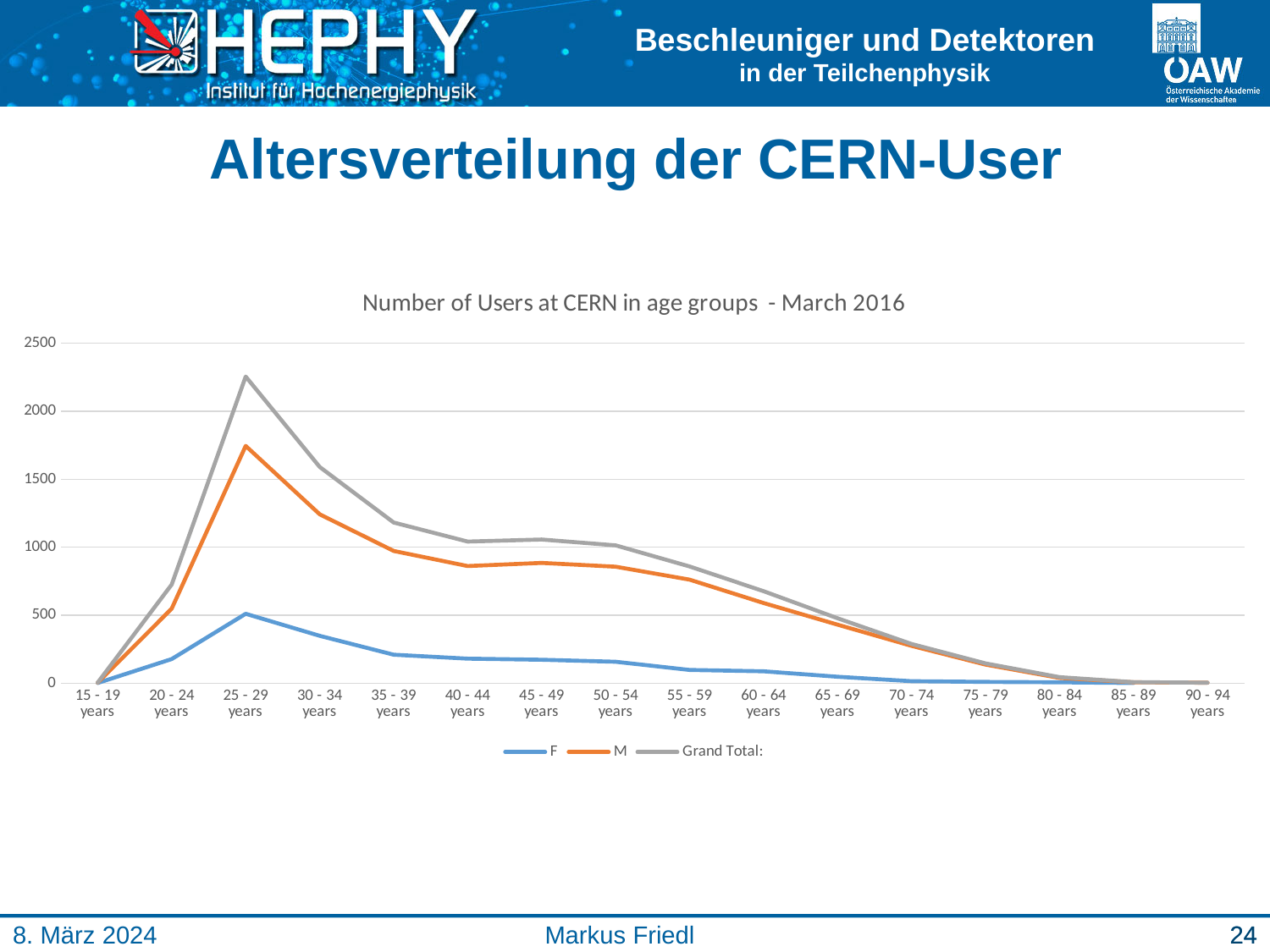
How many series does the legend list? 3 Which age group has the highest value for the M series? 25 - 29 years Is the Grand Total value for 25 - 29 years greater or less than 2000? greater How many age groups are shown on the x axis? 16 What is the title of the chart? Number of Users at CERN in age groups - March 2016 Is the Grand Total value for 20 - 24 years greater or less than 500? greater Which age group has the highest Grand Total value? 25 - 29 years Is the F value for 40 - 44 years greater or less than 500? less What kind of chart is shown on the slide? line chart Which is larger for the 30 - 34 years group, the M value or the F value? M After the 25 - 29 years group, do the Grand Total values rise or fall as age increases? fall